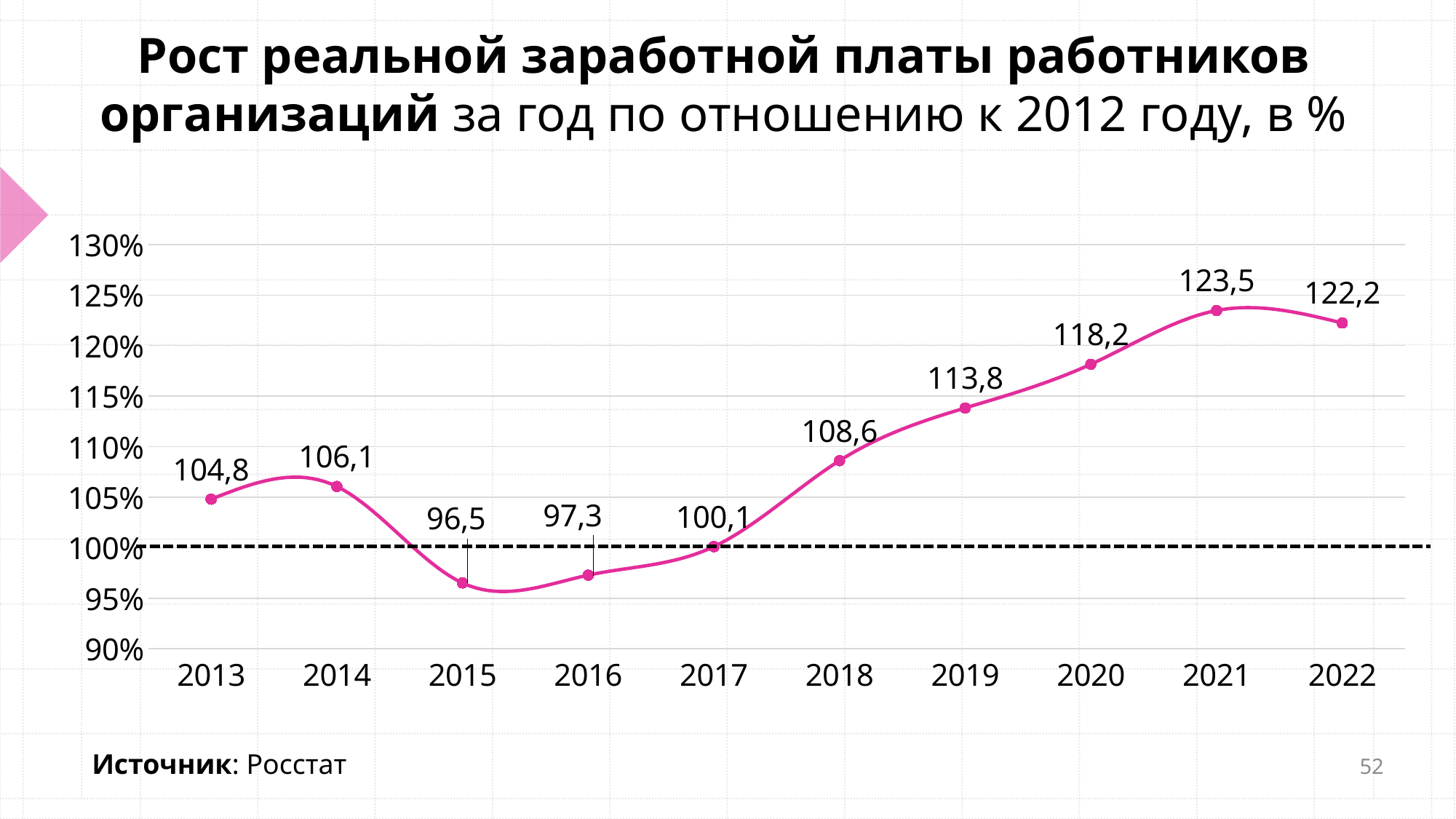
What kind of chart is shown on the slide? line chart Which year has the lowest value? 2015 What is the value for 2017? 100,1 What is the value for 2022? 122,2 How many years are plotted on the chart? 10 Which year has the highest value? 2021 Is the value for 2019 greater or less than 110%? greater What is the value for 2013? 104,8 What is the difference between the values for 2021 and 2020? 5,3 Which is larger, the value for 2014 or the value for 2016? 2014 What source is cited at the bottom of the slide? Росстат Do the values rise or fall from 2017 to 2021? rise